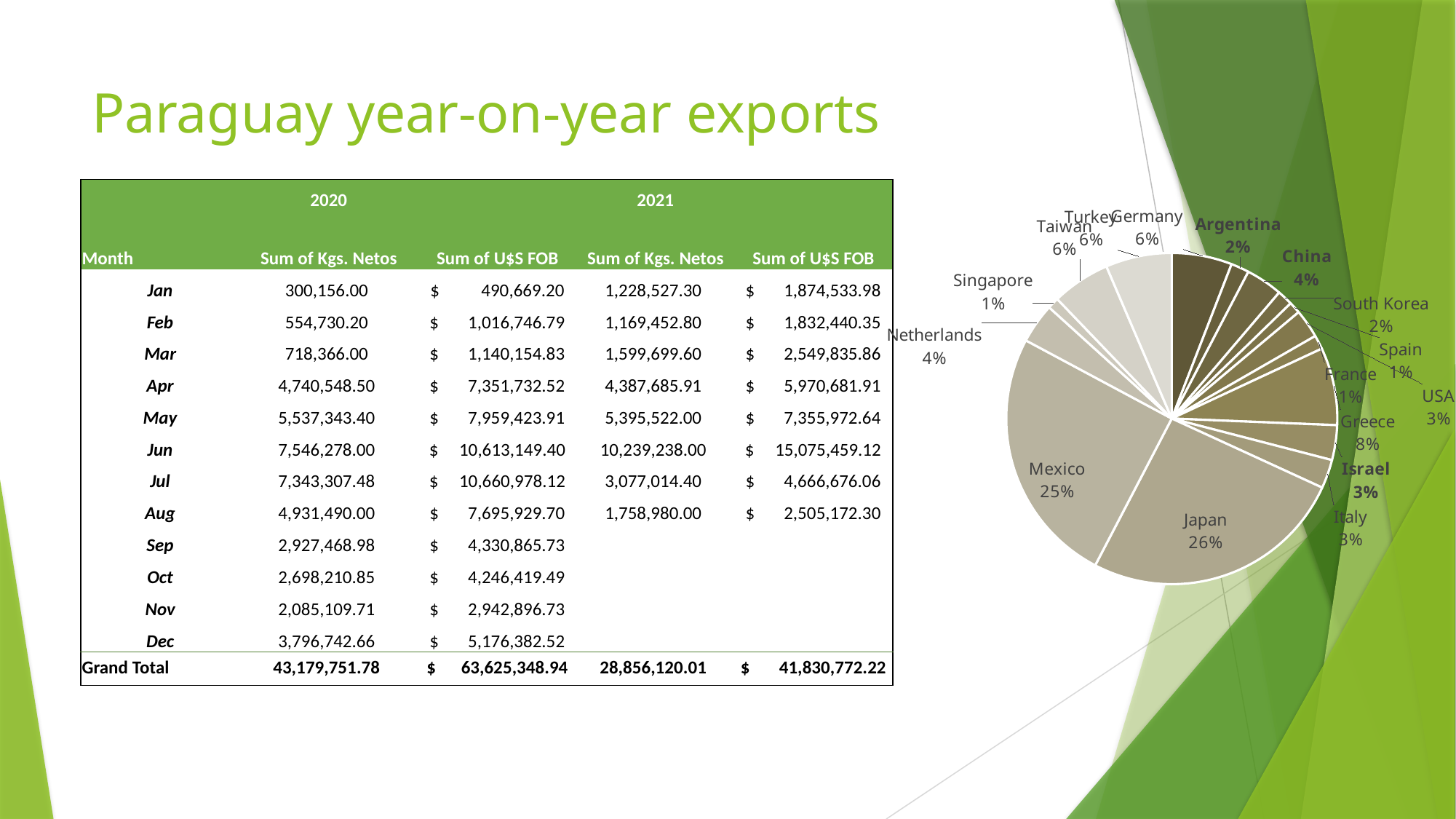
In the pie chart, what share does Taiwan have? 6% In the pie chart, what is the difference in percentage points between Greece's share and China's share? 4% In the pie chart, what share does Japan have? 26% In the pie chart, what share does Netherlands have? 4% In the pie chart, what share does Mexico have? 25% In the pie chart, what share does Greece have? 8% In the pie chart, what is the combined share of Japan and Mexico? 51% Which country has the largest slice in the pie chart? Japan What kind of chart is shown on the right of the slide? pie chart In the pie chart, which is larger, the share for Greece or the share for Israel? Greece How many countries are shown as slices in the pie chart? 16 In the pie chart, what is the difference in percentage points between Japan's share and Mexico's share? 1%